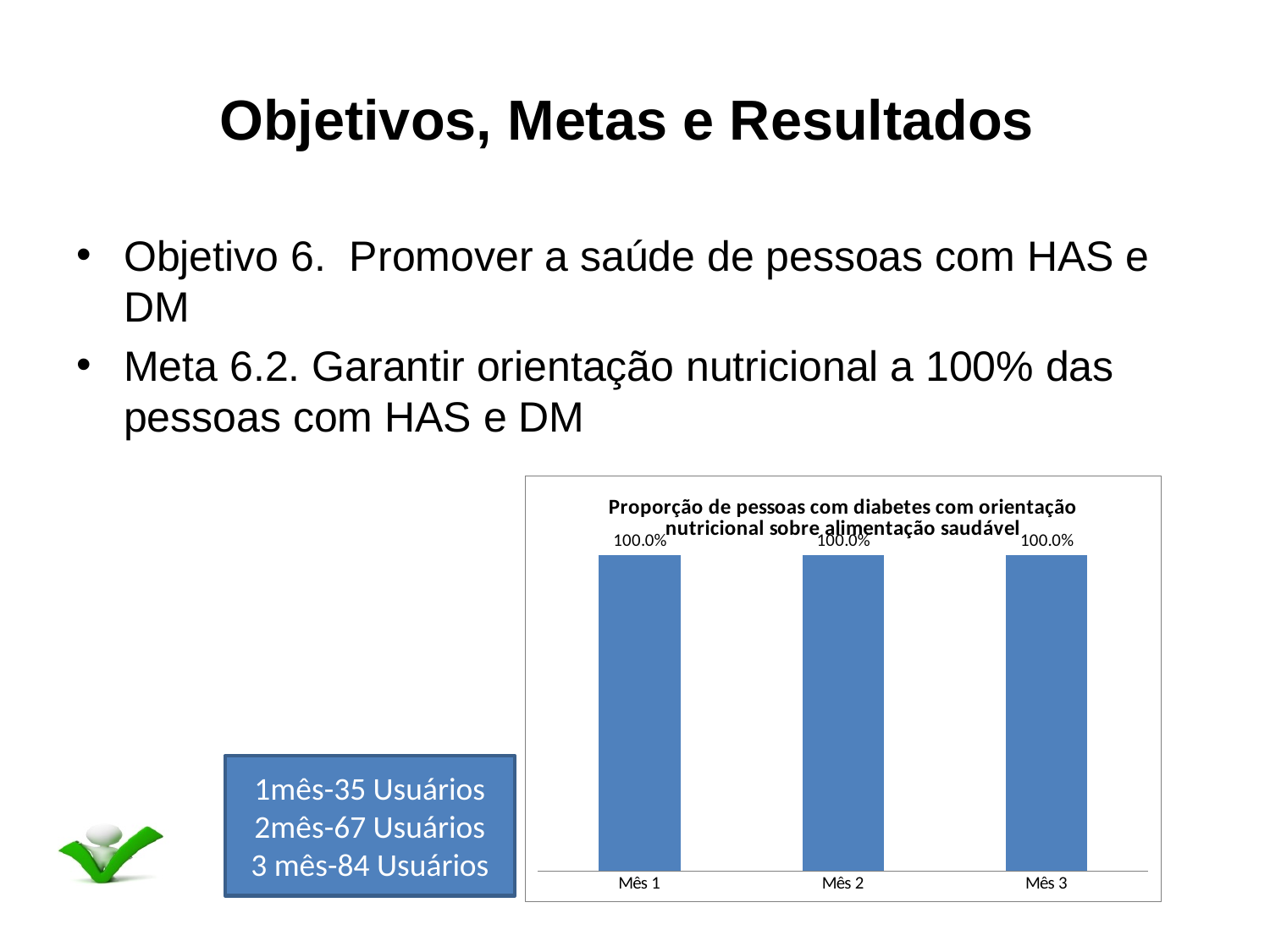
What is the difference between the values for Mês 3 and Mês 1? 0.0% What is the value for Mês 2 in the chart? 100.0% What kind of chart is shown on the slide? Bar chart What is the value for Mês 3 in the chart? 100.0% What is the value for Mês 1 in the chart? 100.0% What is the label of the first category on the x axis? Mês 1 How many categories are shown on the x axis of the chart? 3 What colour are the bars in the chart? Blue What is the title of the chart? Proporção de pessoas com diabetes com orientação nutricional sobre alimentação saudável Do the values rise, fall or stay the same from Mês 1 to Mês 3? Stay the same